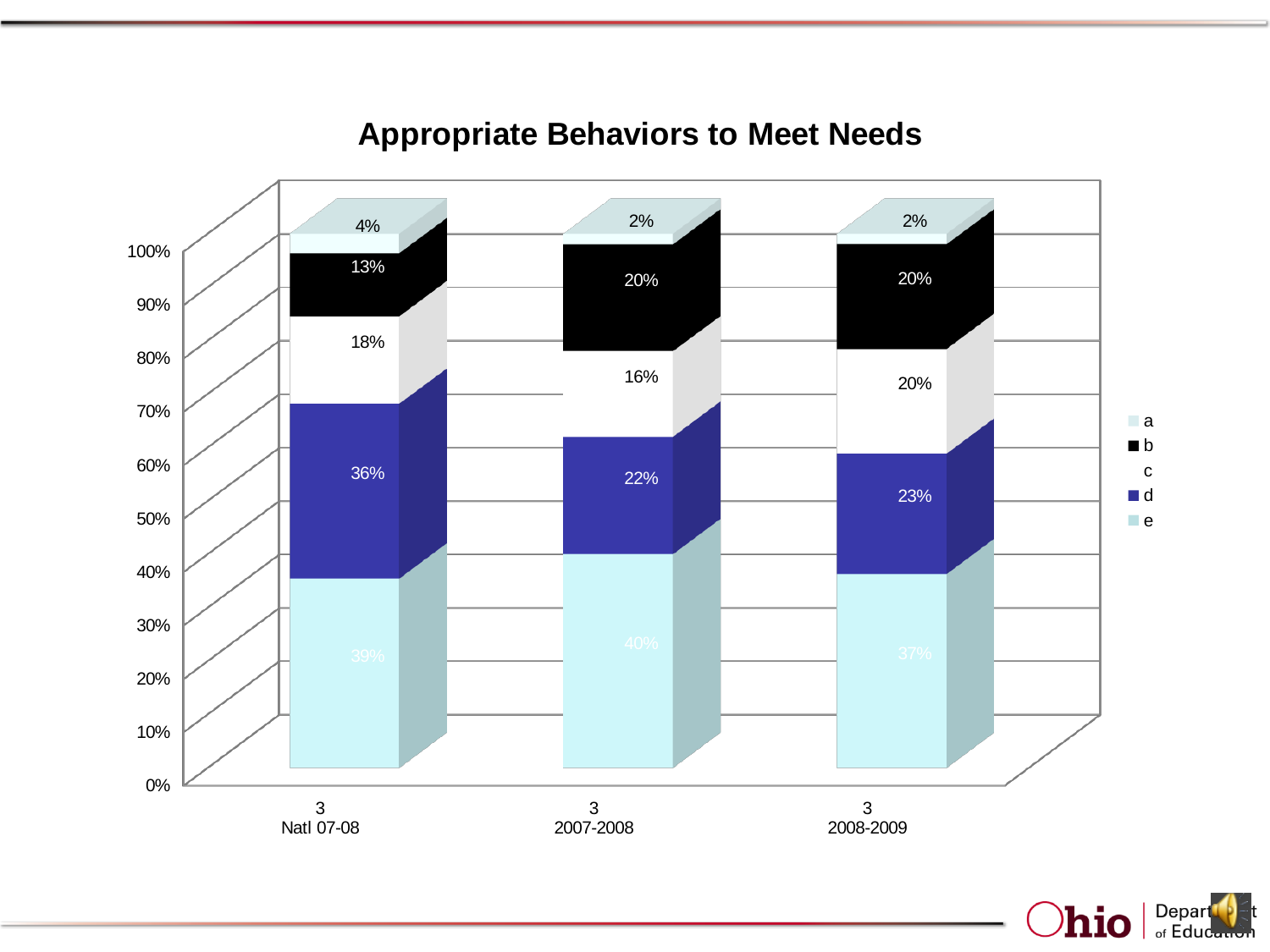
What is the value of series c for 2008-2009? 20% How many series does the legend list? 5 What kind of chart is shown on the slide? Stacked bar chart Is the value of series c larger for Natl 07-08 or for 2007-2008? Natl 07-08 Which category has the lowest value for series e? 2008-2009 What is the title of the chart? Appropriate Behaviors to Meet Needs Which category has the highest value for series d? Natl 07-08 What is the value of series d for Natl 07-08? 36% What is the value of series a for Natl 07-08? 4% What is the difference between the series d values for Natl 07-08 and 2007-2008? 14% What is the value of series b for 2007-2008? 20% How many bars (categories) are shown on the x axis? 3